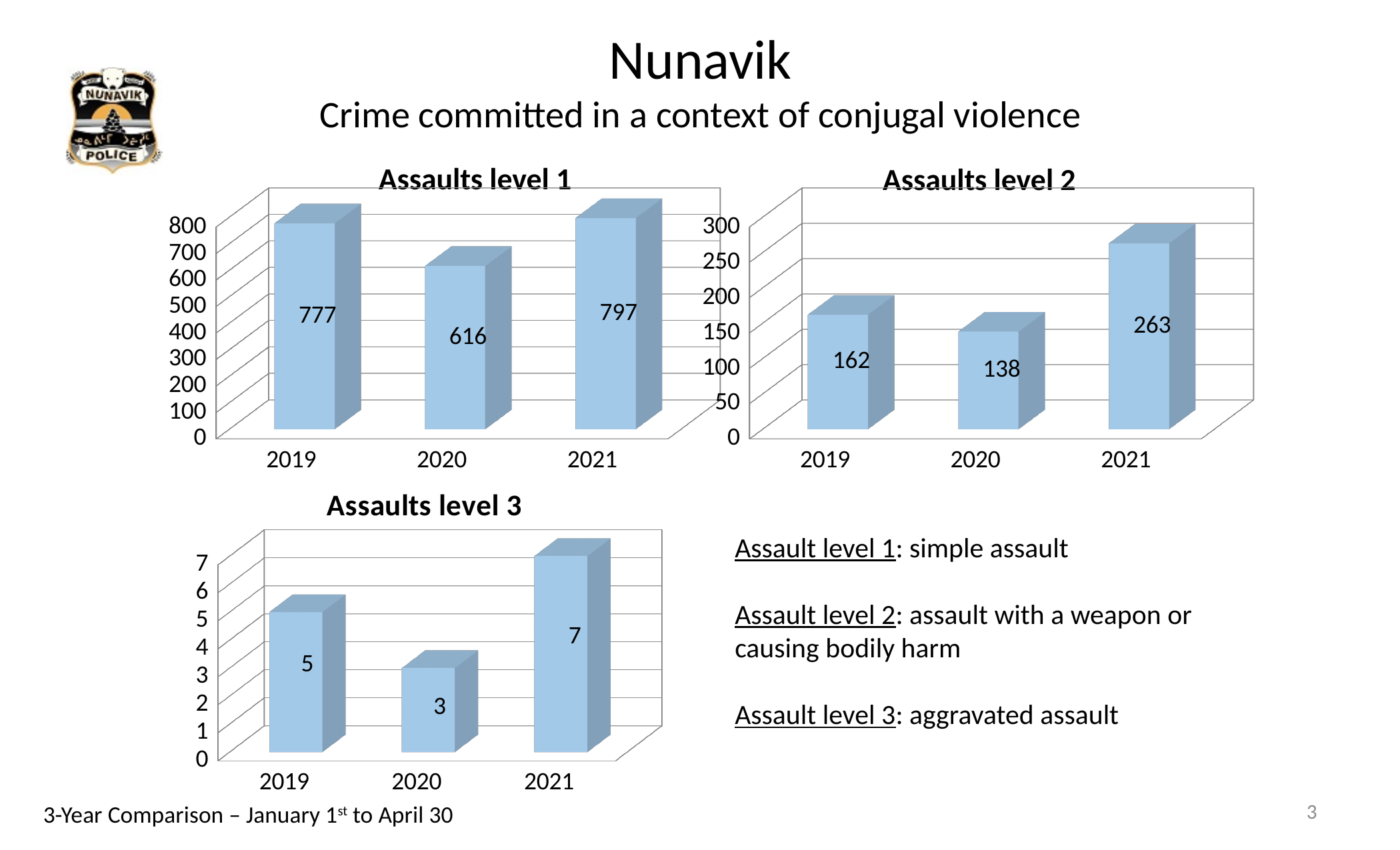
In the 'Assaults level 3' chart, which year has the highest value? 2021 In the 'Assaults level 2' chart, what is the difference between the 2021 and 2020 values? 125 In the 'Assaults level 3' chart, what is the value for 2019? 5 In the 'Assaults level 3' chart, which is larger, the value for 2019 or the value for 2020? 2019 What kind of chart is the 'Assaults level 3' chart? bar chart In the 'Assaults level 2' chart, what is the value for 2021? 263 In the 'Assaults level 2' chart, is the value for 2021 greater or less than 250? greater In the 'Assaults level 1' chart, which year has the highest value? 2021 In the 'Assaults level 2' chart, which year has the lowest value? 2020 In the 'Assaults level 1' chart, what is the difference between the 2021 and 2019 values? 20 In the 'Assaults level 1' chart, what is the value for 2020? 616 How many years are shown in the 'Assaults level 1' chart? 3